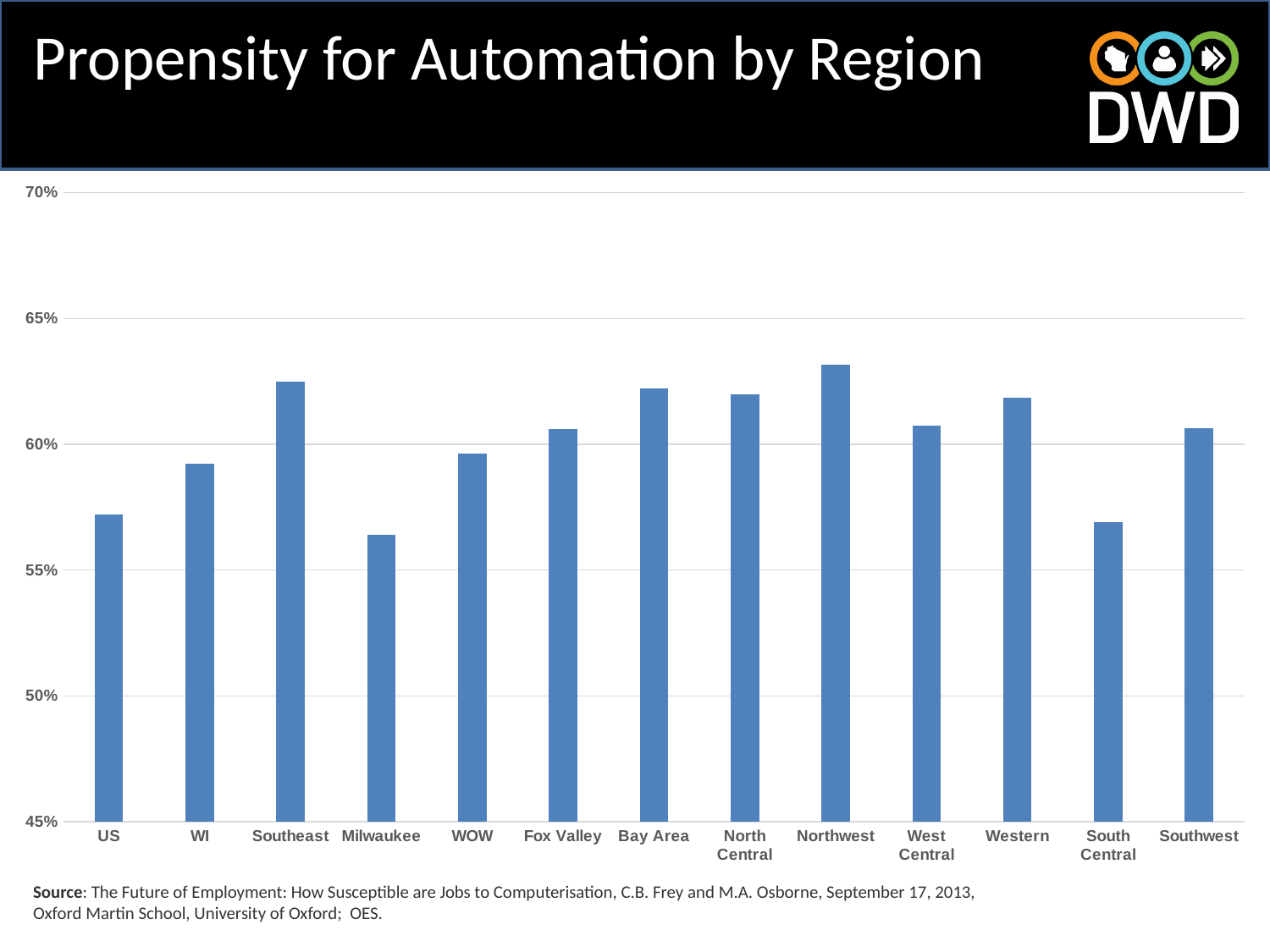
Is the value for Milwaukee greater or less than 60%? less How many regions (bars) are shown on the chart? 13 Which has a higher value, Southeast or Milwaukee? Southeast Which has a higher value, WI or Bay Area? Bay Area Which region has the lowest propensity for automation? Milwaukee What kind of chart is shown on the slide? Bar chart What is the title of the slide's chart? Propensity for Automation by Region Is the value for Northwest greater or less than 65%? less Is the value for US greater or less than 55%? greater Which has a higher value, US or WI? WI Which region has the highest propensity for automation? Northwest